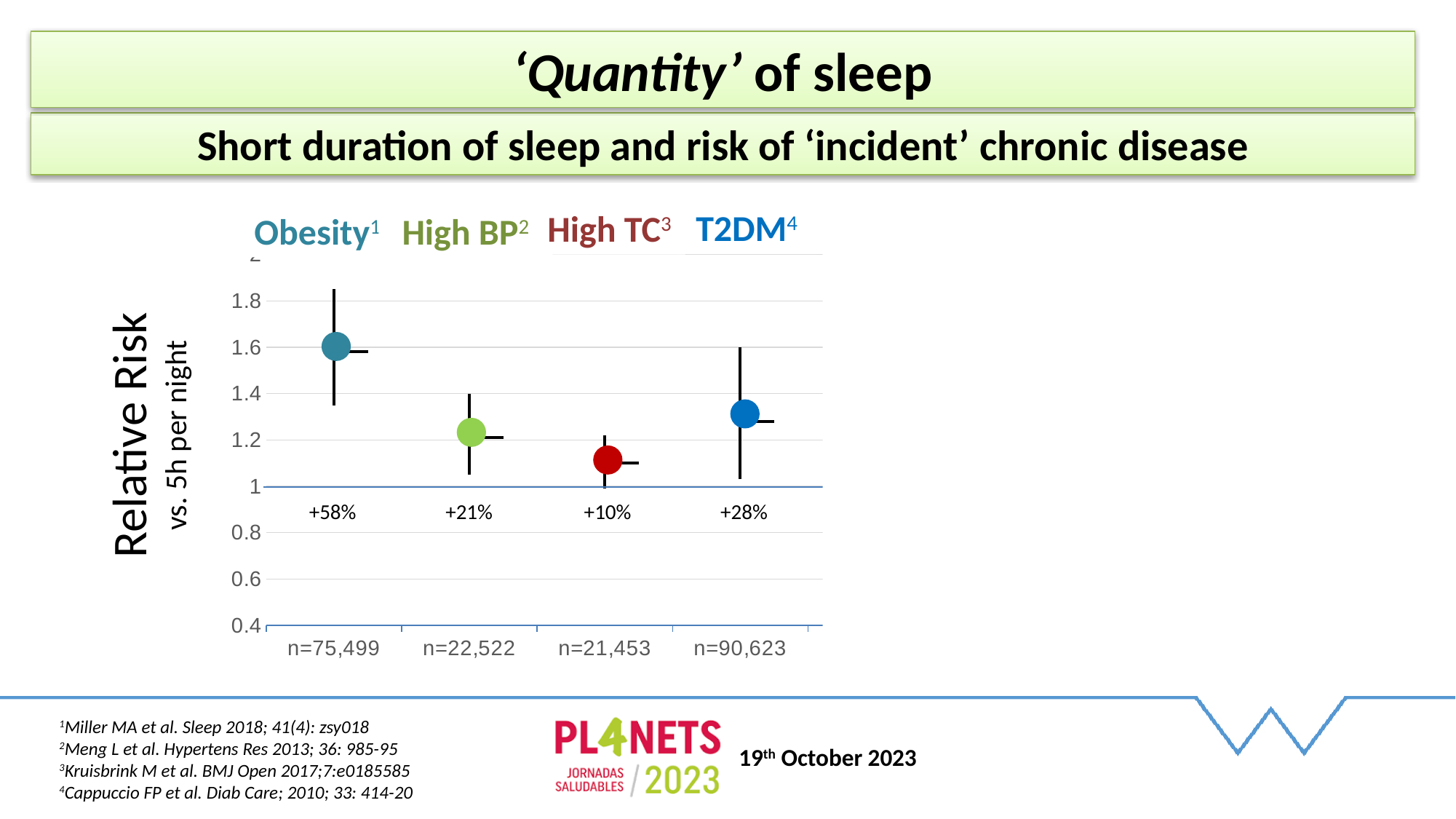
What percentage increase in risk is shown for High TC? +10% How many conditions are plotted in the chart? 4 Is the relative risk for High TC greater or less than 1.2? less Which has a larger relative risk, Obesity or T2DM? Obesity Which condition has the lowest relative risk in the chart? High TC What is the sample size (n) shown for T2DM? n=90,623 What is the y-axis label of the chart? Relative Risk vs. 5h per night What percentage increase in risk is shown for T2DM? +28% Is the relative risk for Obesity greater or less than 1.4? greater What percentage increase in risk is shown for Obesity? +58% What is the sample size (n) shown for High BP? n=22,522 Which condition has the highest relative risk in the chart? Obesity